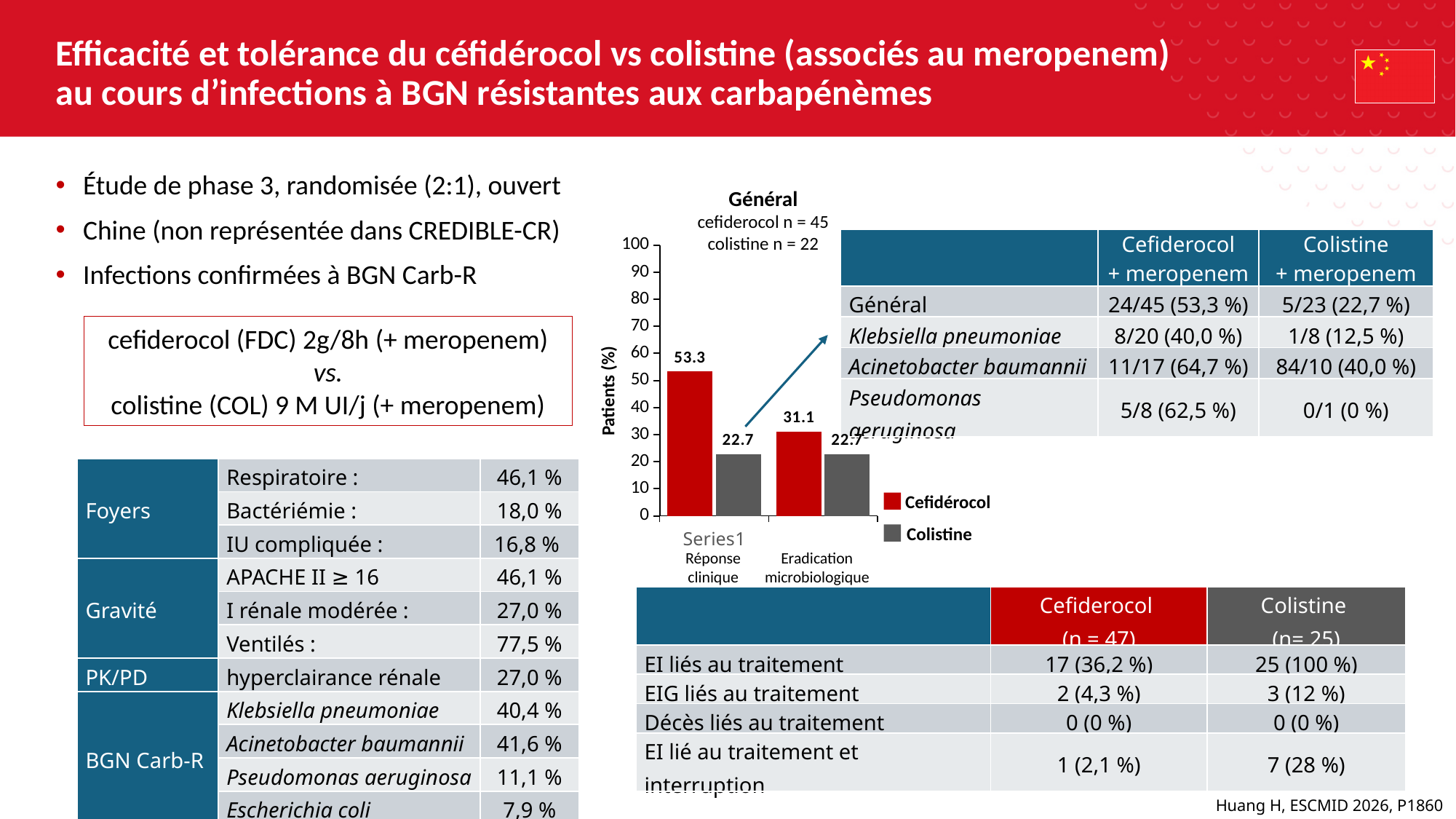
In the bar chart, what is the value for Cefidérocol for Réponse clinique? 53.3 In the bar chart, what is the difference between Cefidérocol and Colistine for Eradication microbiologique? 8.4 In the bar chart, what is the value for Colistine for Réponse clinique? 22.7 In the bar chart, what is the value for Cefidérocol for Eradication microbiologique? 31.1 In the bar chart, what is the value for Colistine for Eradication microbiologique? 22.7 In the bar chart, which bar has the highest value? Cefidérocol, Réponse clinique What type of chart is shown on the slide? bar chart How many series does the legend of the bar chart list? 2 How many categories are shown on the x axis of the bar chart? 2 In the bar chart, what is the difference between Cefidérocol and Colistine for Réponse clinique? 30.6 In the bar chart, which is larger for Eradication microbiologique: Cefidérocol or Colistine? Cefidérocol What is the label of the y axis of the bar chart? Patients (%)